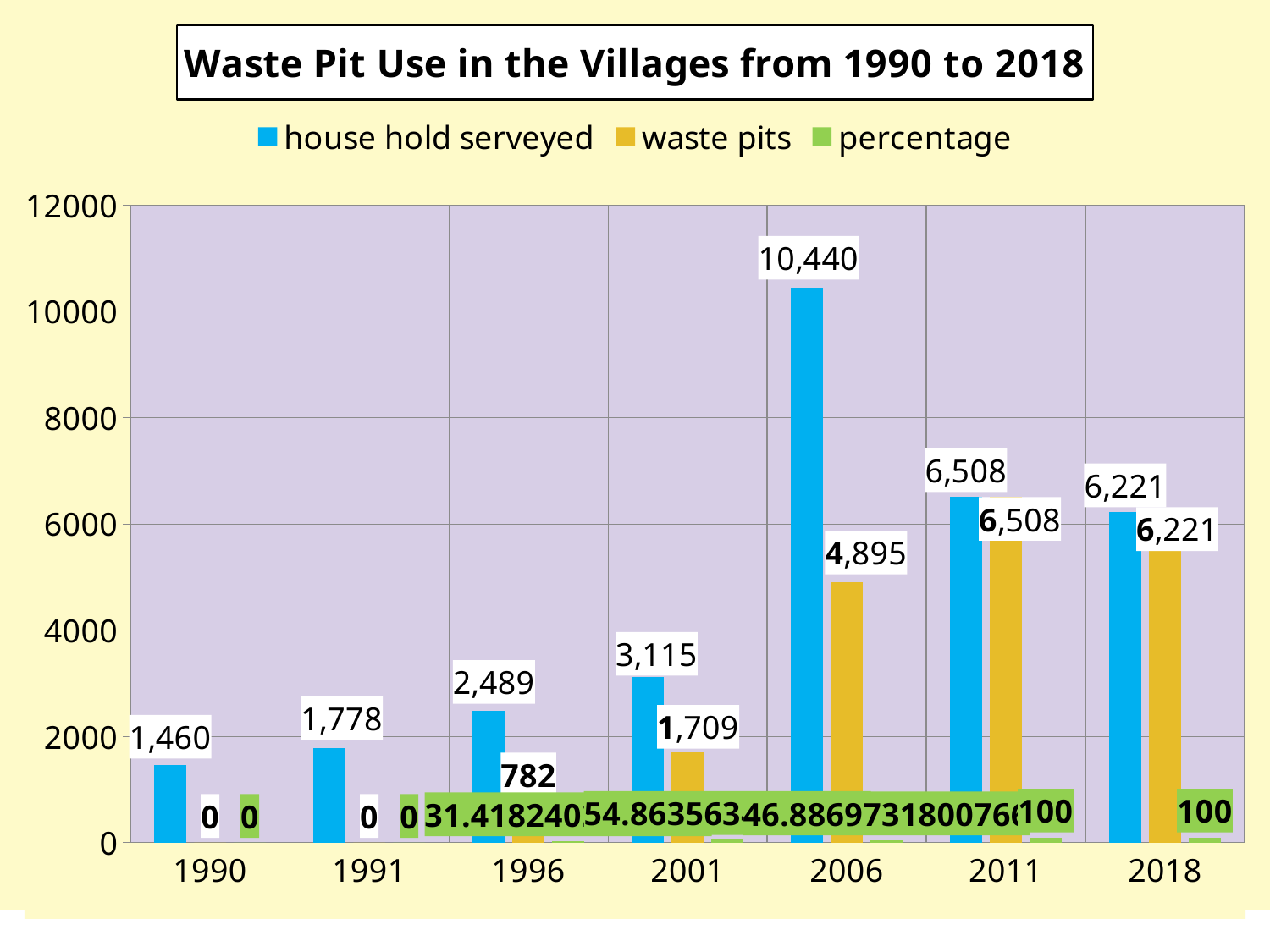
Which is larger: households surveyed in 2011 or households surveyed in 2018? 2011 What type of chart is shown on the slide? bar chart Which year has the lowest number of households surveyed? 1990 How many years are shown on the x axis? 7 What is the difference between households surveyed and waste pits in 2006? 5,545 What is the title of the chart? Waste Pit Use in the Villages from 1990 to 2018 How many households were surveyed in 2006? 10,440 What is the percentage value shown for 2018? 100 What is the number of waste pits in 2001? 1,709 What is the number of waste pits in 1996? 782 Which year has the highest number of households surveyed? 2006 How many series does the legend list? 3